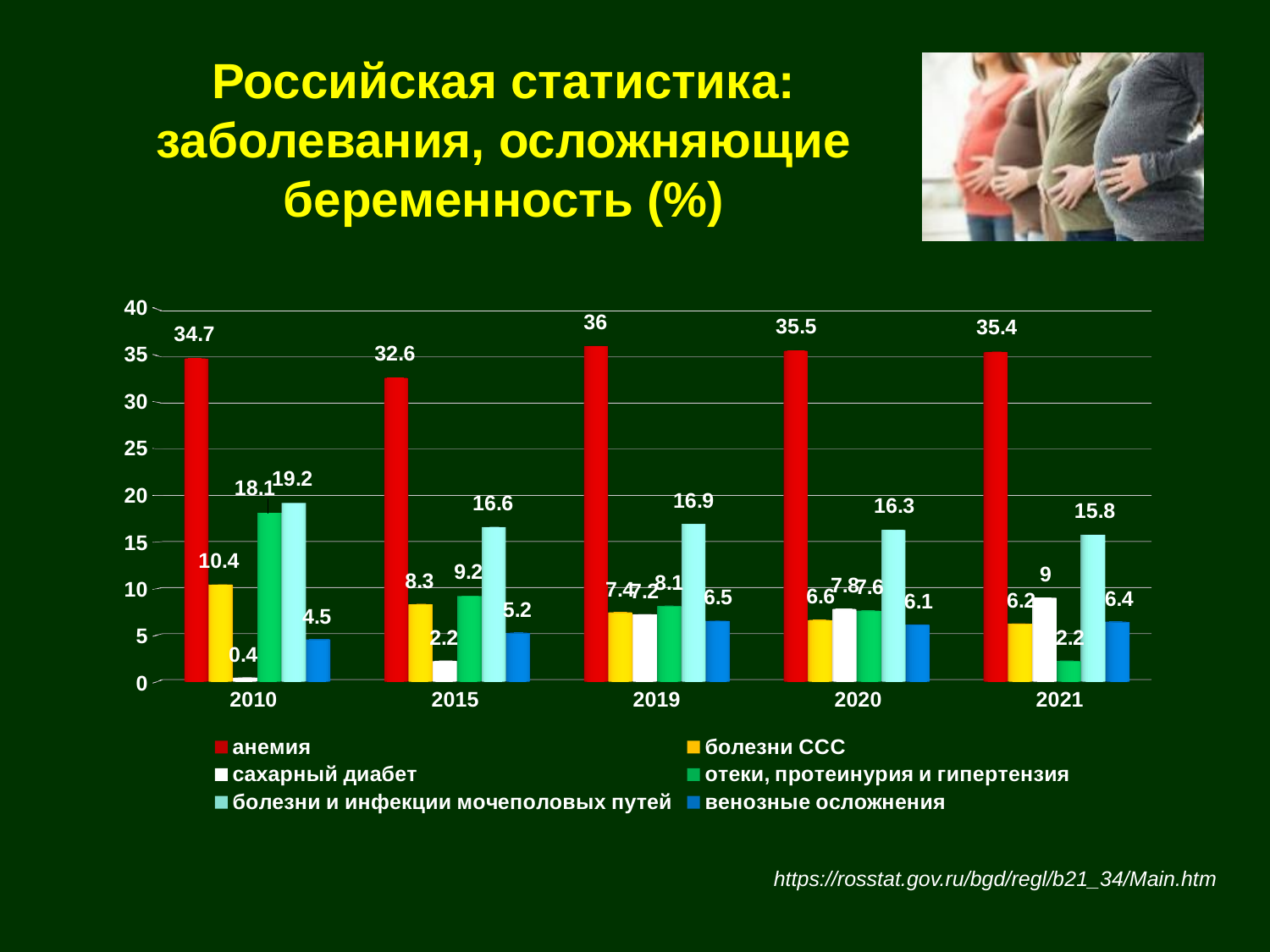
Which is larger: болезни ССС in 2010 or болезни ССС in 2021? болезни ССС in 2010 Is the value for болезни и инфекции мочеполовых путей in 2021 greater or less than 20? less What is the value for анемия in 2019? 36 What is the value for венозные осложнения in 2015? 5.2 What is the value for сахарный диабет in 2021? 9 What kind of chart is shown on the slide? bar chart In which year is the value for сахарный диабет the lowest? 2010 What is the difference between the анемия values in 2019 and 2015? 3.4 What is the value for болезни и инфекции мочеполовых путей in 2010? 19.2 How many years are shown on the x axis? 5 In which year is the value for анемия the highest? 2019 How many series does the legend list? 6